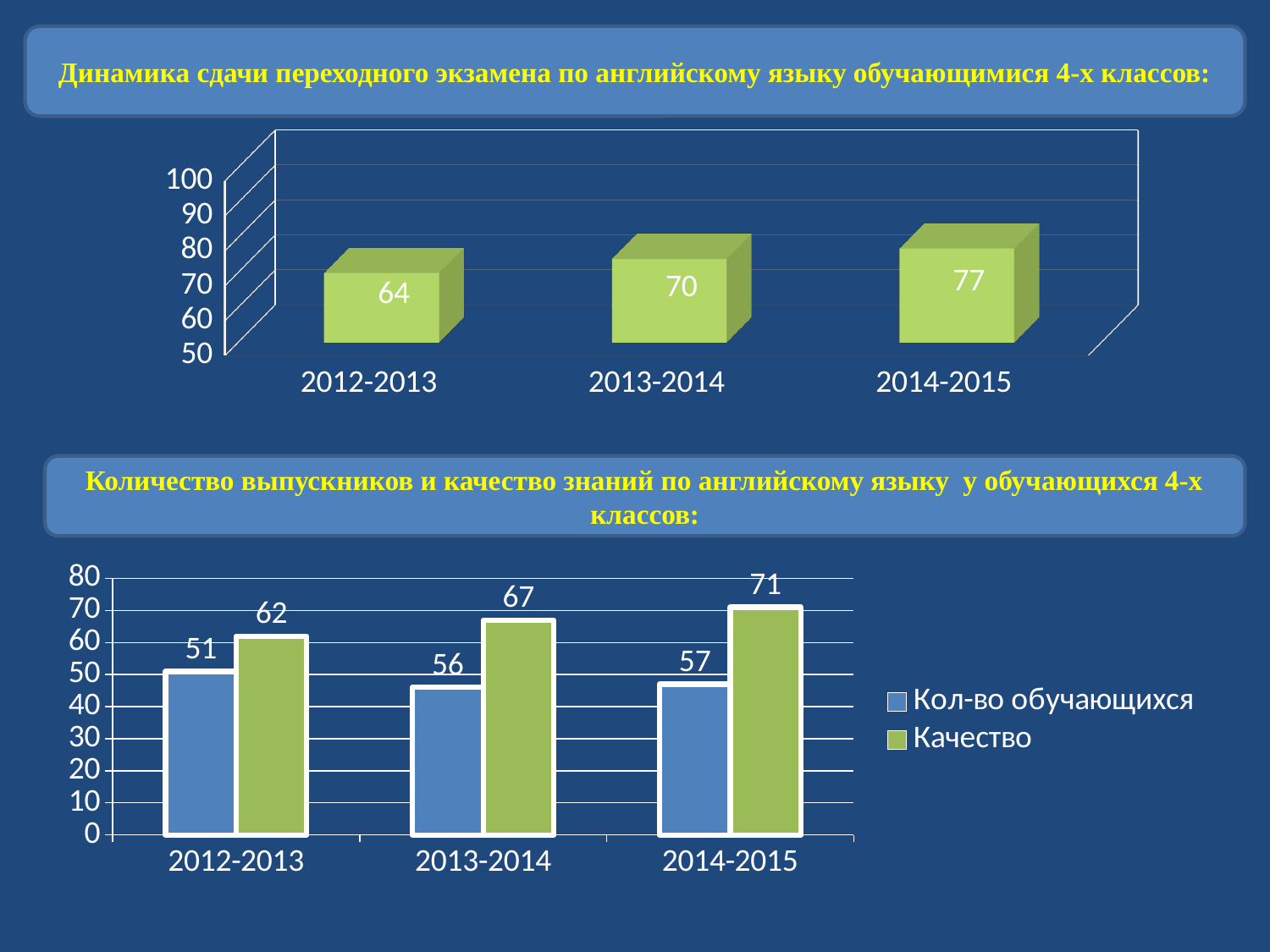
In the top chart, what is the value for 2012-2013? 64 In the bottom chart, what is the value of Кол-во обучающихся for 2013-2014? 56 In the top chart, what is the difference between the values for 2014-2015 and 2012-2013? 13 In the bottom chart, what is the value of Качество for 2014-2015? 71 In the top chart, do the values rise or fall from 2012-2013 to 2014-2015? rise What kind of chart is the bottom chart? bar chart In the bottom chart, how many series does the legend list? 2 In the top chart, which year has the highest value? 2014-2015 In the top chart, what is the value for 2014-2015? 77 In the top chart, how many categories are shown on the x axis? 3 In the bottom chart, what is the difference between Качество and Кол-во обучающихся for 2012-2013? 11 In the bottom chart, which year has the lowest value for Качество? 2012-2013